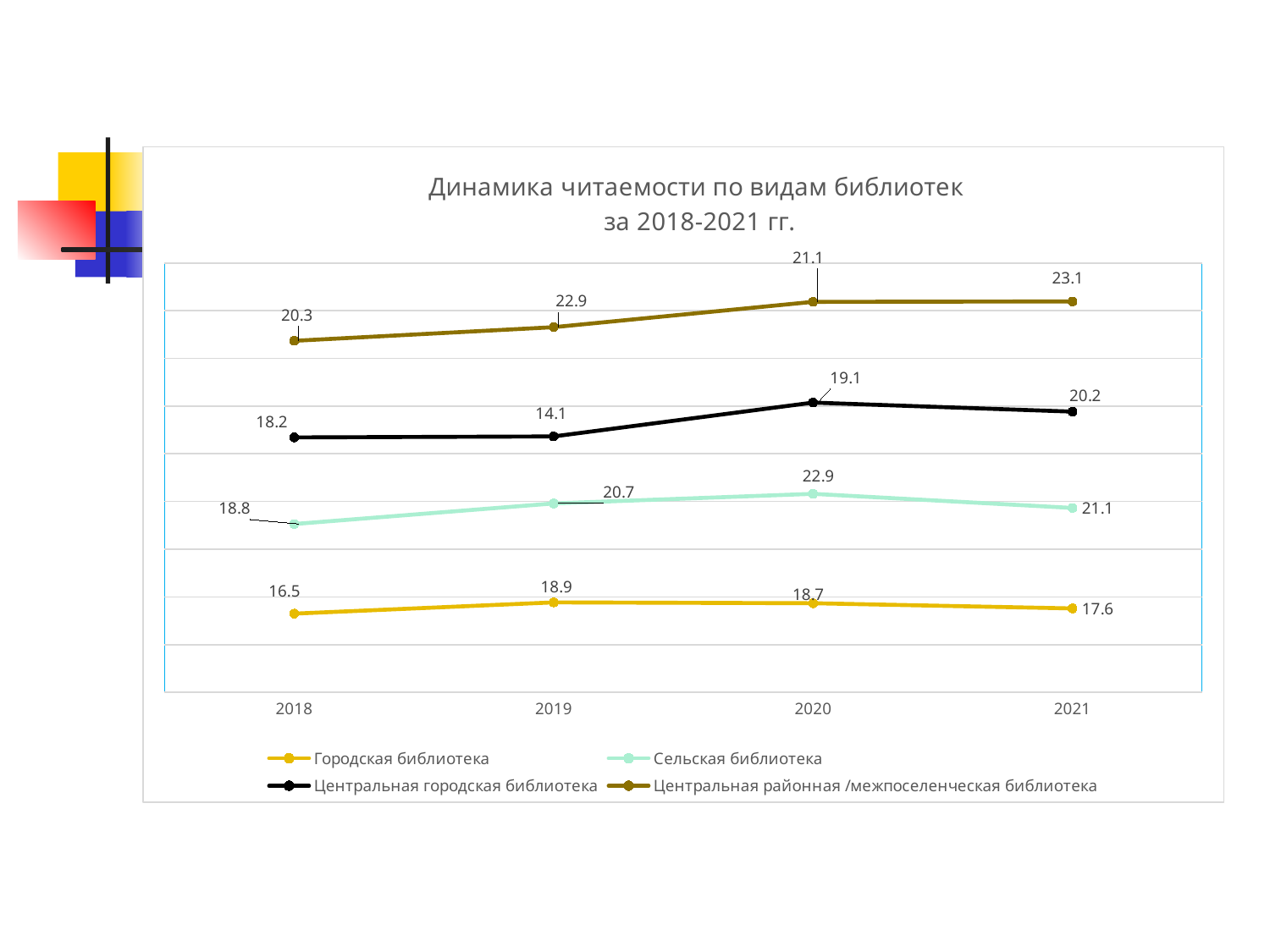
What is the value for Центральная городская библиотека in 2019? 14.1 What is the value for Городская библиотека in 2018? 16.5 How many years are shown on the x axis? 4 In which year does Городская библиотека have its lowest value? 2018 In 2021, which is larger: the value for Сельская библиотека or for Городская библиотека? Сельская библиотека Does the value for Городская библиотека rise or fall from 2019 to 2021? Fall What is the value for Центральная районная /межпоселенческая библиотека in 2021? 23.1 What kind of chart is shown on the slide? Line chart By how much did the value for Сельская библиотека increase from 2018 to 2020? 4.1 In which year does Центральная районная /межпоселенческая библиотека reach its highest value? 2021 How many series does the legend list? 4 What is the value for Сельская библиотека in 2020? 22.9